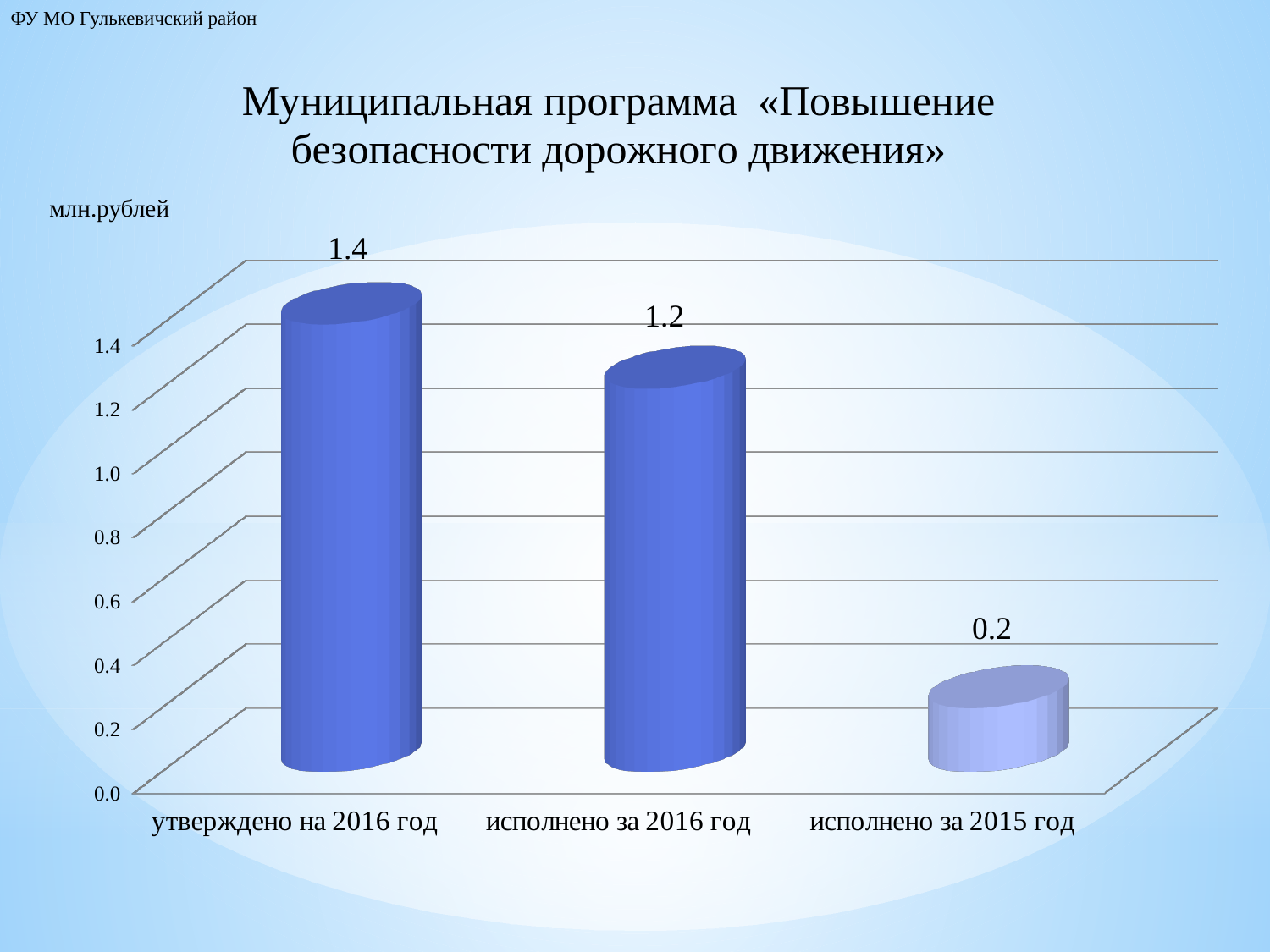
What is the value for «исполнено за 2015 год»? 0.2 Is the value for «исполнено за 2015 год» greater or less than 0.4? less What kind of chart is shown on the slide? bar chart Which is larger: the value for «исполнено за 2016 год» or «исполнено за 2015 год»? исполнено за 2016 год What unit is indicated for the values on the chart? млн.рублей Which category has the lowest value? исполнено за 2015 год What is the difference between the value for «исполнено за 2016 год» and «исполнено за 2015 год»? 1.0 What is the value for «утверждено на 2016 год»? 1.4 What is the value for «исполнено за 2016 год»? 1.2 How many categories are shown on the chart? 3 Which category has the highest value? утверждено на 2016 год What is the difference between the value for «утверждено на 2016 год» and «исполнено за 2016 год»? 0.2